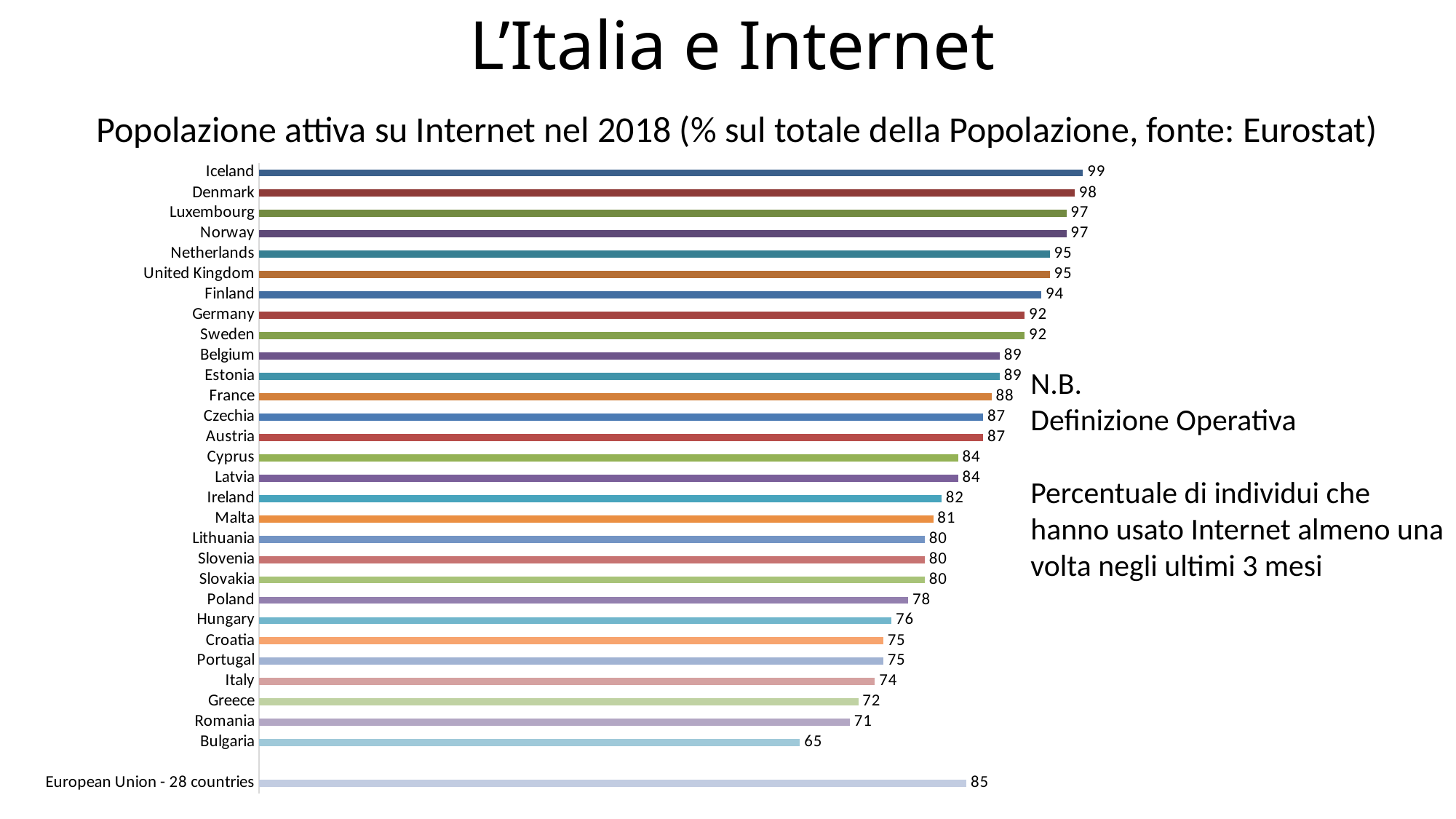
What is the title of the chart? Popolazione attiva su Internet nel 2018 (% sul totale della Popolazione, fonte: Eurostat) How many bars are shown in the chart? 30 What kind of chart is shown on the slide? Bar chart What is the difference between the value for European Union - 28 countries and the value for Italy? 11 What is the value for European Union - 28 countries? 85 Which is larger, the value for Poland or the value for Malta? Malta What is the value for Italy? 74 Which is larger, the value for Italy or the value for Greece? Italy Which country has the highest value? Iceland What is the difference between the value for Iceland and the value for Bulgaria? 34 Which country has the lowest value? Bulgaria What is the value for Germany? 92